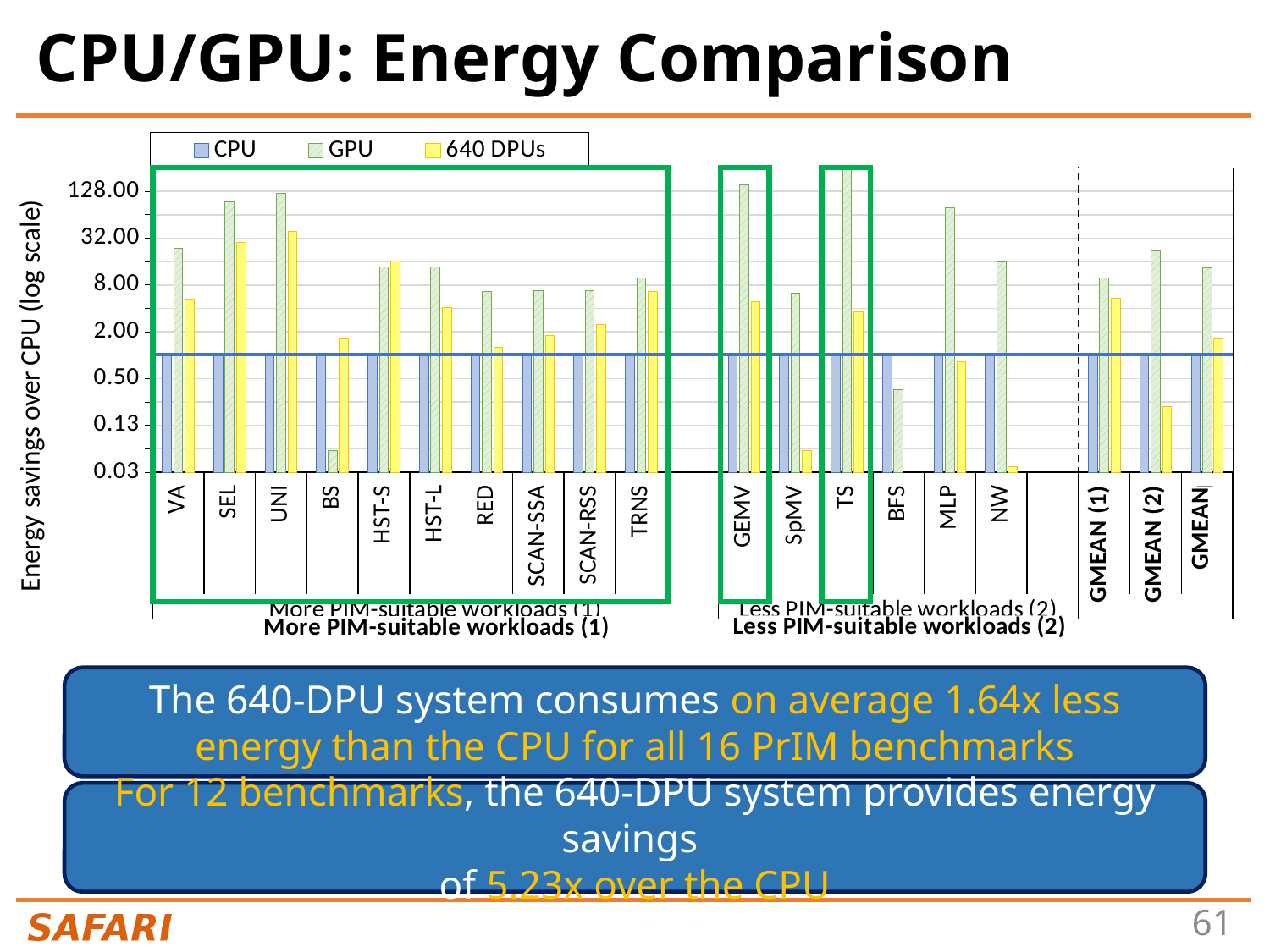
Which workload has the highest 640 DPUs bar? UNI What are the three series named in the legend? CPU, GPU, 640 DPUs For VA, which is larger: the GPU value or the 640 DPUs value? GPU How many series does the legend list? 3 How many workload categories are shown along the x axis, including the GMEAN entries? 19 What is the label of the vertical axis? Energy savings over CPU (log scale) For BS, which is larger: the GPU value or the 640 DPUs value? 640 DPUs Which workload has the lowest GPU bar? BS Is the GPU value for UNI greater or less than 32.00? greater Is the 640 DPUs value for NW greater or less than 0.13? less What kind of chart is shown on the slide? bar chart Which workload has the highest GPU bar? TS